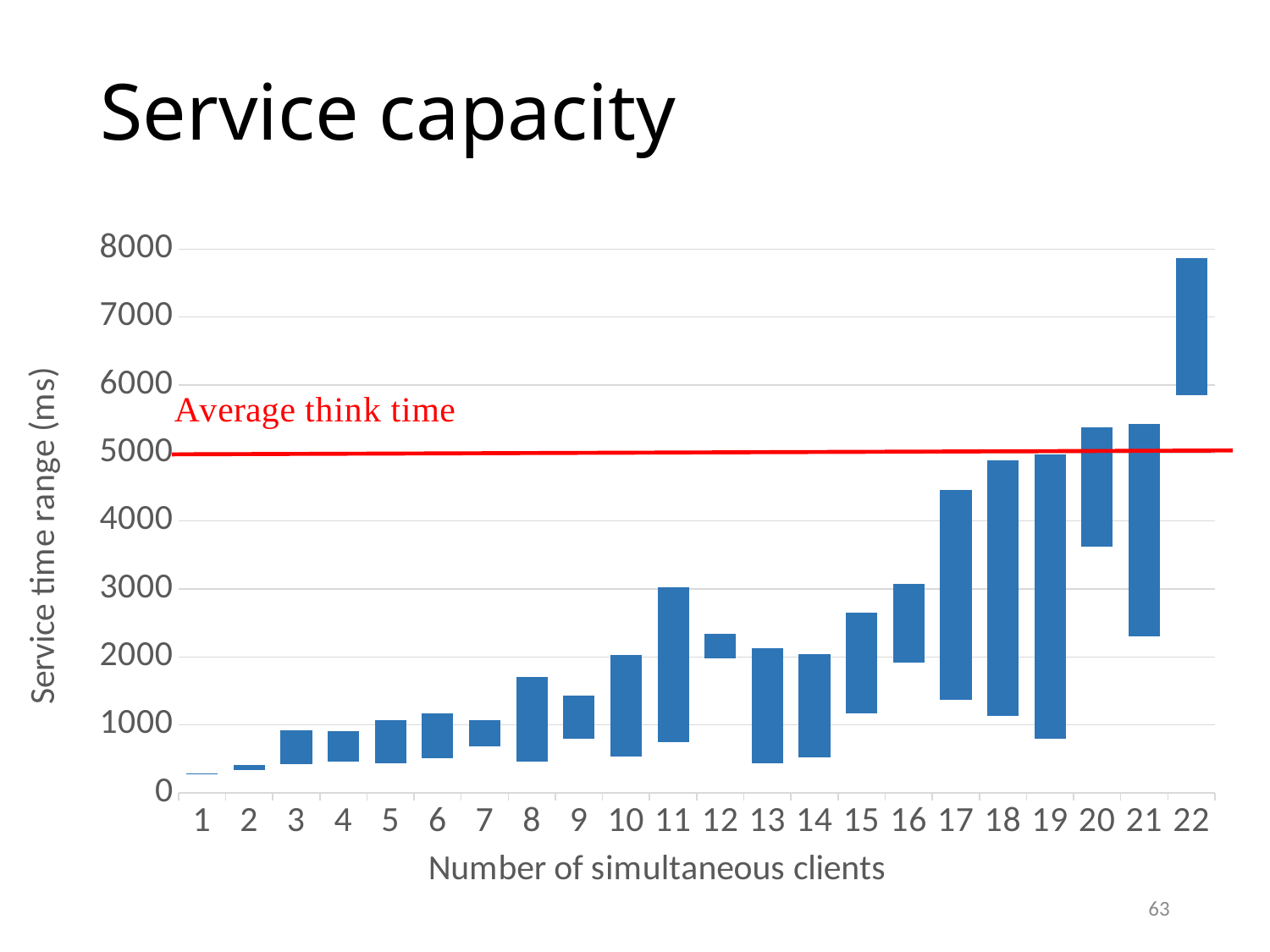
Is the upper end of the service time range for 17 clients greater or less than 5000? less Is the upper end of the service time range for 22 clients greater or less than 7000? greater Which has a higher upper end of service time range, 22 clients or 21 clients? 22 clients Is the upper end of the service time range for 20 clients greater or less than 5000? greater Which number of simultaneous clients has the highest upper end of service time range? 22 What is the title of the x axis? Number of simultaneous clients What kind of chart is shown on the slide? bar chart Which number of simultaneous clients has the lowest service time range? 1 What does the red horizontal line on the chart represent? Average think time Do the service time ranges generally rise or fall as the number of simultaneous clients increases? rise How many client counts (categories) are plotted along the x axis? 22